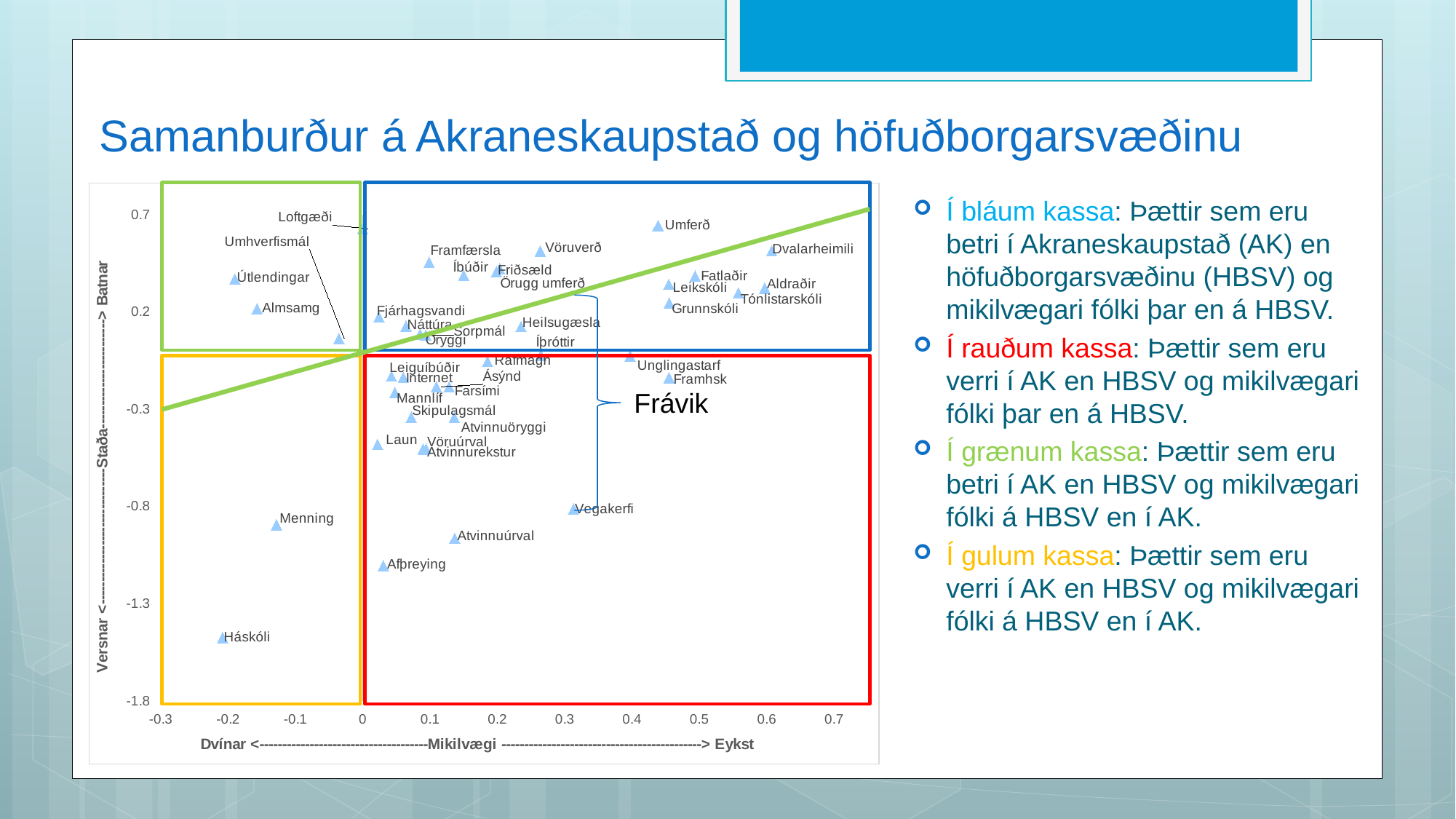
Is the vertical-axis value for Menning greater or less than -0.8? less What kind of chart is shown on the slide? scatter chart Is the horizontal-axis value for Menning greater or less than -0.1? less Which has the higher vertical-axis value, Umferð or Vegakerfi? Umferð Which has the higher horizontal-axis value, Dvalarheimili or Háskóli? Dvalarheimili Which point has the lowest value on the vertical (Staða) axis? Háskóli Is the vertical-axis value for Laun greater or less than -0.3? less What word is written in the annotation with the bracket inside the red box? Frávik